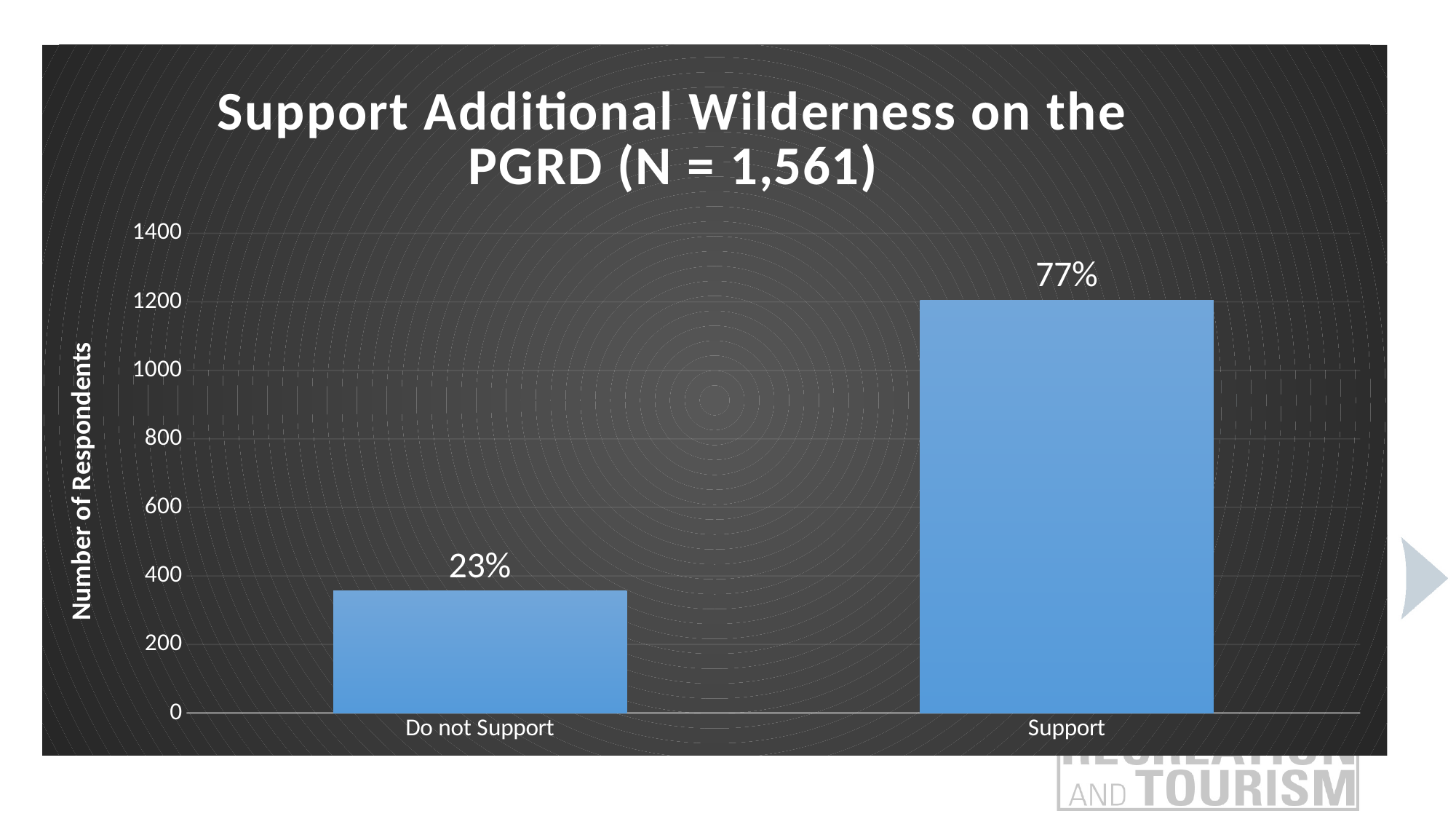
Which is larger, the value for Support or the value for Do not Support? Support What is the label on the vertical axis? Number of Respondents What kind of chart is shown on the slide? Bar chart Is the number of respondents for Support greater or less than 1000? greater What is the title of the chart? Support Additional Wilderness on the PGRD (N = 1,561) What data label is shown on the Do not Support bar? 23% Is the number of respondents for Do not Support greater or less than 400? less Which category has the highest bar? Support Which category has the lowest bar? Do not Support What is the difference in percentage points between the Support label and the Do not Support label? 54 percentage points How many categories are shown on the x axis? 2 What data label is shown on the Support bar? 77%